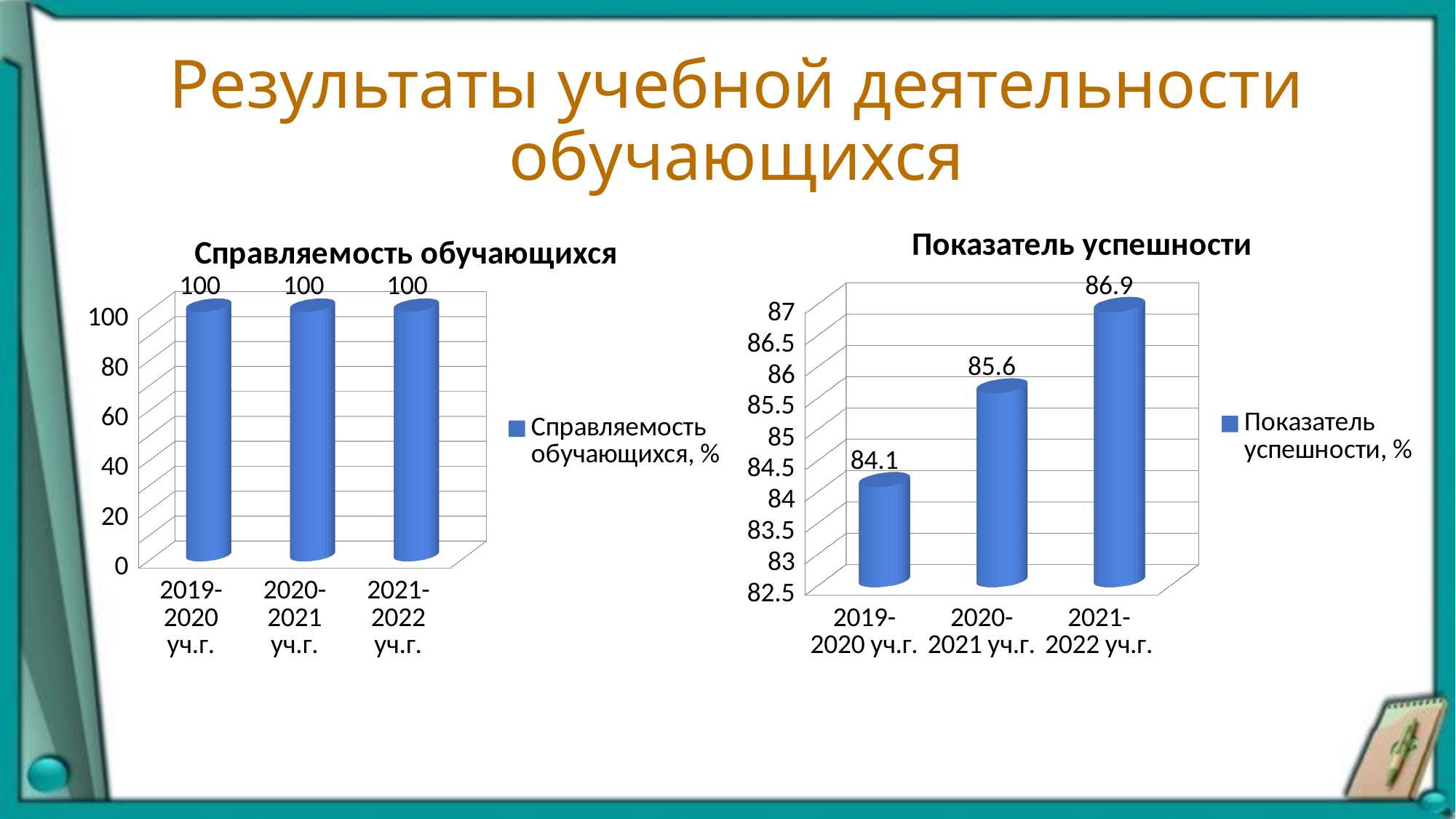
How many series does the legend of the chart titled 'Показатель успешности' list? 1 In the chart titled 'Справляемость обучающихся', what is the value for 2020-2021 уч.г.? 100 In the chart titled 'Показатель успешности', what is the value for 2021-2022 уч.г.? 86.9 In the chart titled 'Показатель успешности', is the value for 2020-2021 уч.г. greater or less than 85? greater In the chart titled 'Показатель успешности', which academic year has the highest value? 2021-2022 уч.г. In the chart titled 'Показатель успешности', which is larger: the value for 2020-2021 уч.г. or 2019-2020 уч.г.? 2020-2021 уч.г. In the chart titled 'Показатель успешности', which academic year has the lowest value? 2019-2020 уч.г. What kind of chart is the chart titled 'Справляемость обучающихся'? bar chart How many academic years are shown in the chart titled 'Справляемость обучающихся'? 3 In the chart titled 'Показатель успешности', what is the value for 2019-2020 уч.г.? 84.1 In the chart titled 'Показатель успешности', what is the difference between the values for 2021-2022 уч.г. and 2019-2020 уч.г.? 2.8 In the chart titled 'Показатель успешности', do the values rise or fall from 2019-2020 to 2021-2022? rise